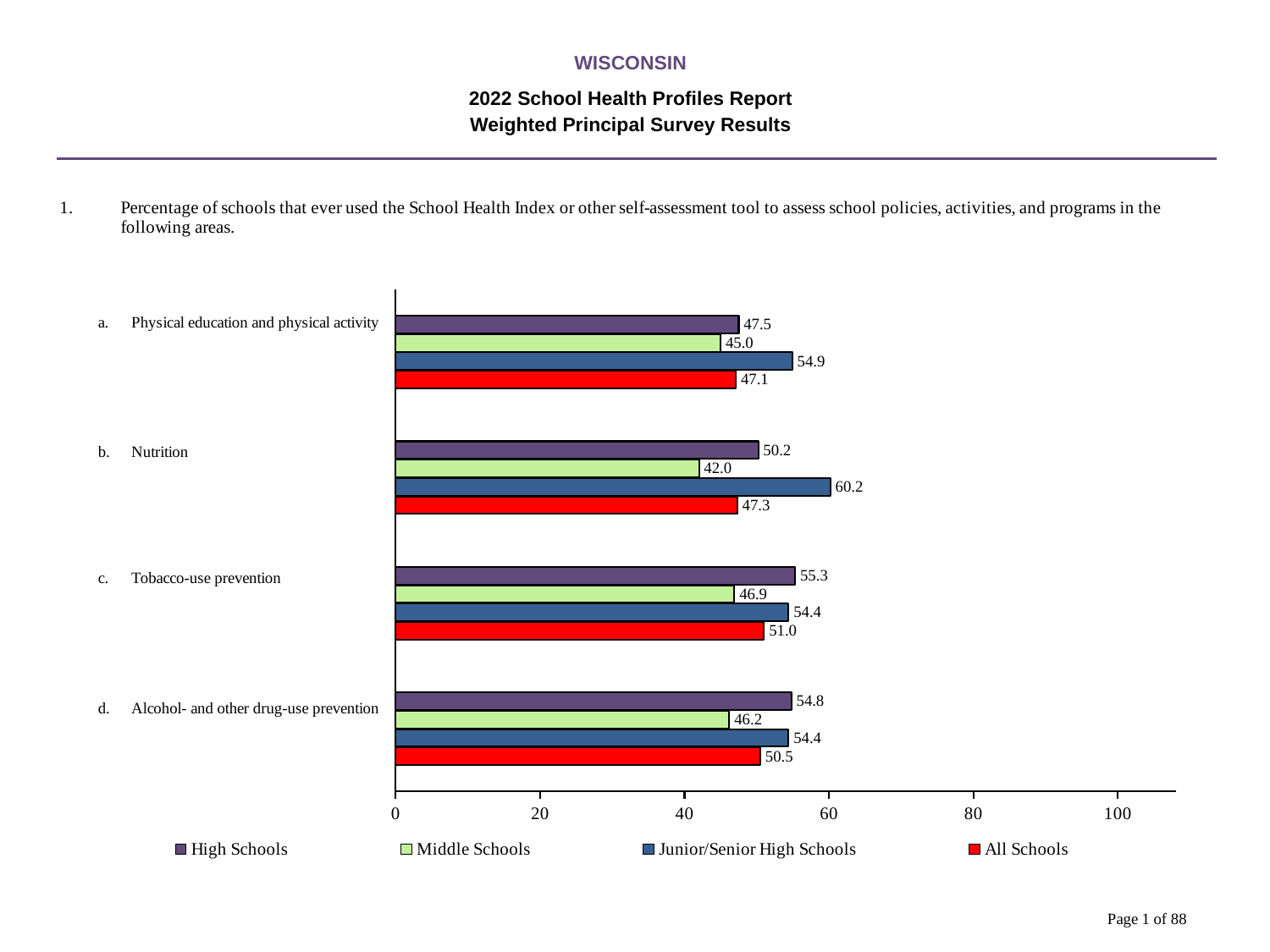
For Tobacco-use prevention, which is larger: the High Schools value or the Middle Schools value? High Schools What is the difference between the Junior/Senior High Schools and Middle Schools values for Nutrition? 18.2 What is the value for Junior/Senior High Schools for Nutrition? 60.2 What is the value for All Schools for Tobacco-use prevention? 51.0 How many categories are shown on the chart? 4 What is the value for High Schools for Alcohol- and other drug-use prevention? 54.8 How many series does the legend list? 4 Which series is shown in red in the legend? All Schools What is the value for Middle Schools for Physical education and physical activity? 45.0 Which category has the highest value for Junior/Senior High Schools? Nutrition Which category has the lowest value for Middle Schools? Nutrition What kind of chart is shown on the slide? Bar chart